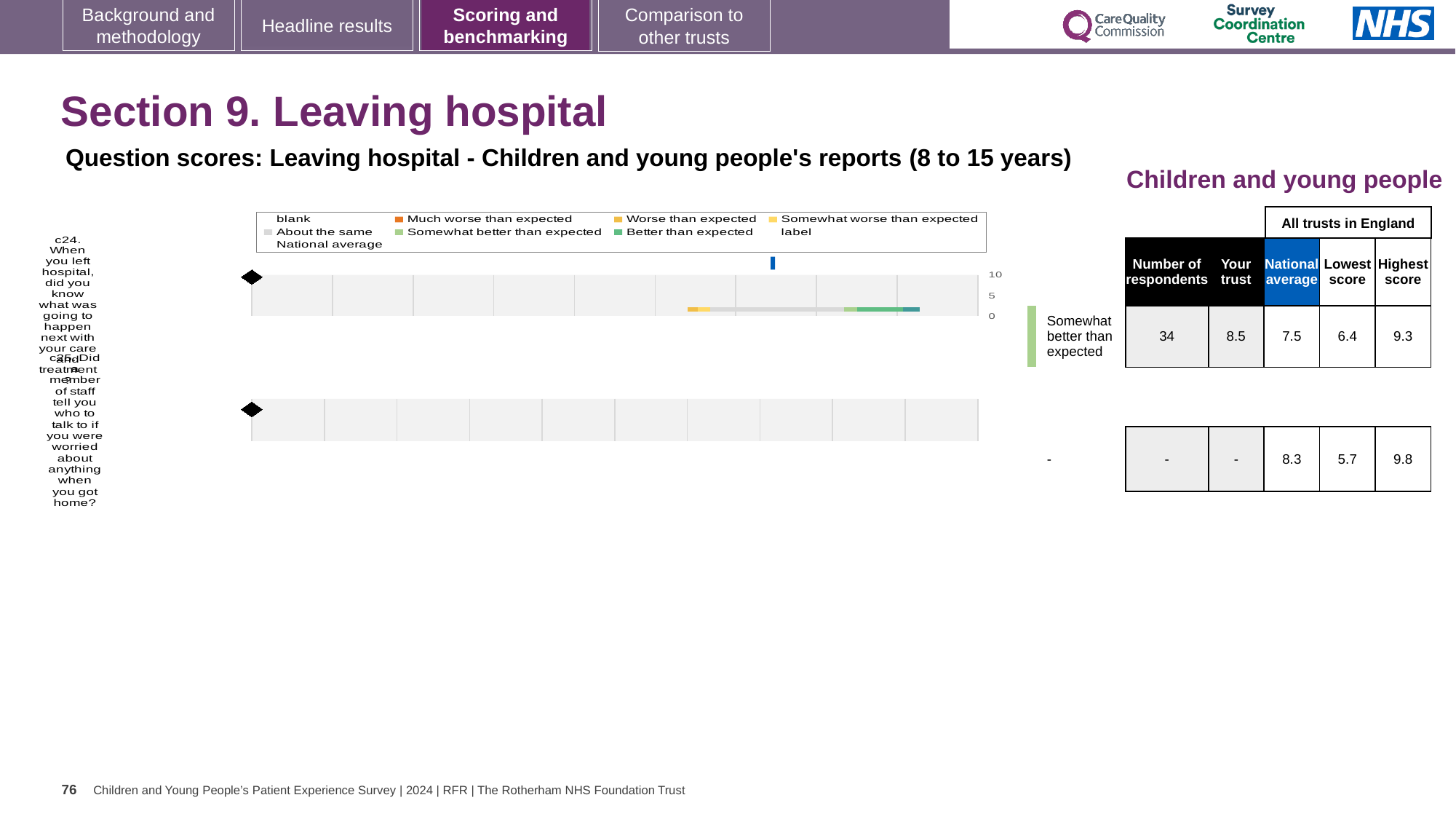
How many entries does the chart legend list? 9 Is the 'Your trust' score for question c24 greater or less than 5 on the chart axis? greater What is the national average score for question c24? 7.5 What benchmarking category label is shown next to question c24? Somewhat better than expected What is the lowest score across all trusts in England for question c25? 5.7 How many respondents answered question c24? 34 How many questions (rows) are plotted in the chart? 2 What is the highest score across all trusts in England for question c25? 9.8 For question c24, which is larger: the 'Your trust' score or the national average? Your trust What is the difference between the highest score (9.3) and the lowest score (6.4) for question c24? 2.9 What is the 'Your trust' score for question c24? 8.5 What kind of chart is used to show the question scores on this slide? bar chart